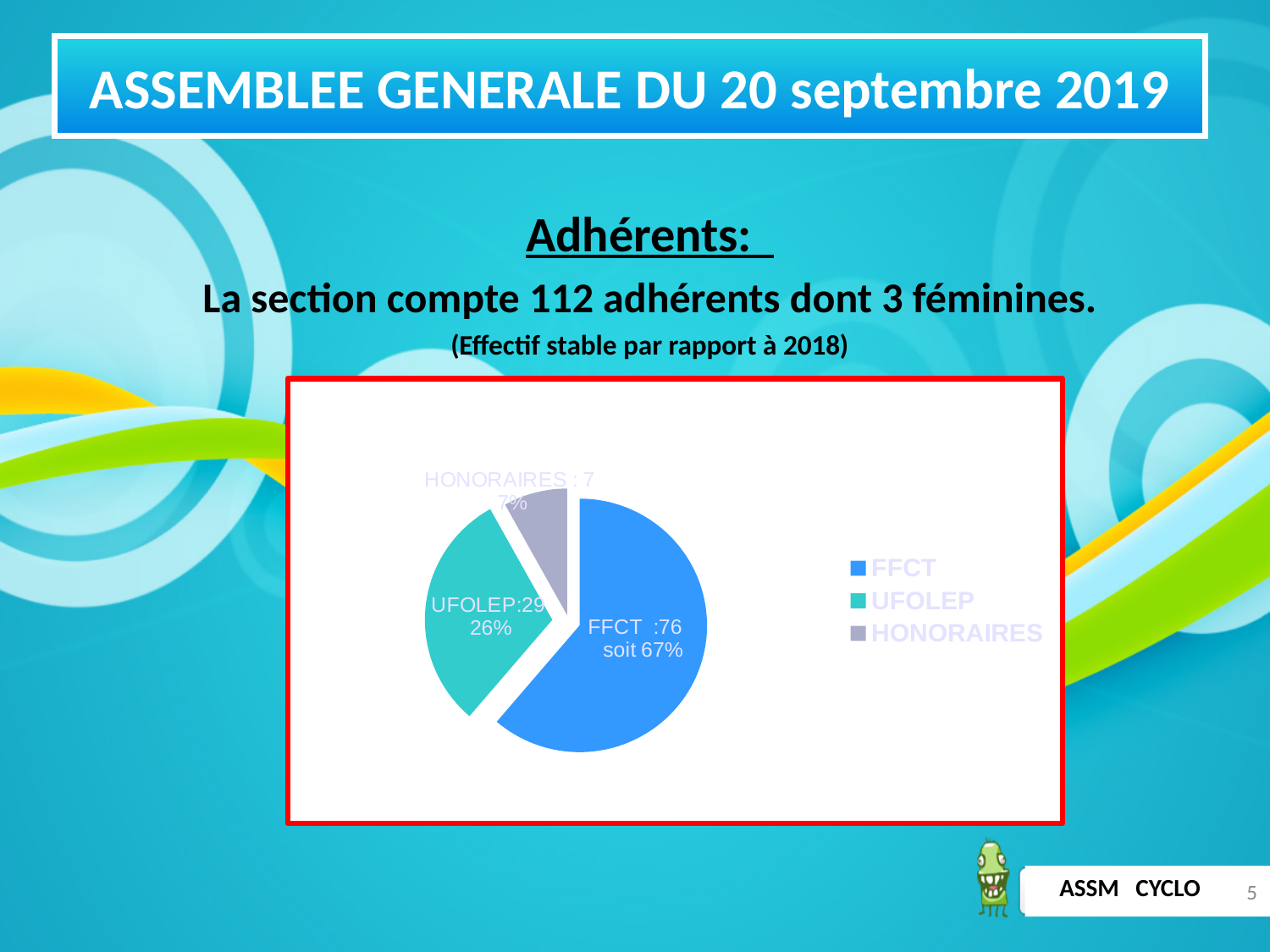
What percentage share of the pie does FFCT represent? 67% What is the value shown for UFOLEP in the pie chart? 29 Which legend entry is shown in blue in the pie chart? FFCT Which category has the largest slice in the pie chart? FFCT What percentage share of the pie does UFOLEP represent? 26% How many slices does the pie chart have? 3 What kind of chart is shown on the slide? pie chart How many entries does the legend of the pie chart list? 3 Which category has the smallest slice in the pie chart? HONORAIRES What is the difference between the FFCT value and the UFOLEP value in the pie chart? 47 What is the value shown for FFCT in the pie chart? 76 What is the value shown for HONORAIRES in the pie chart? 7